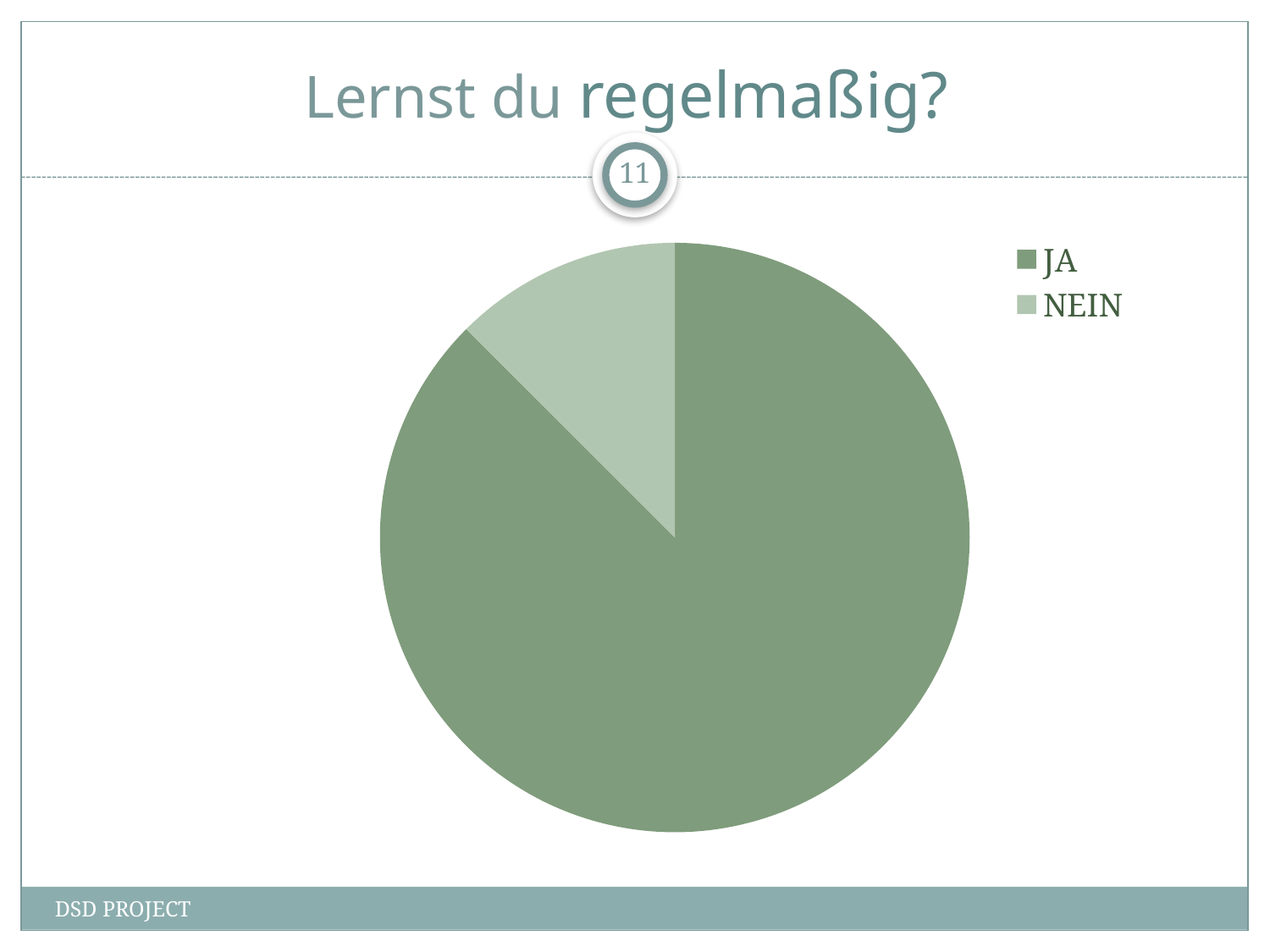
How many slices does the pie chart have? 2 How many entries does the legend of the pie chart list? 2 What kind of chart is shown on the slide? pie chart What is the title of the slide containing the pie chart? Lernst du regelmaßig? Which category has the largest slice in the pie chart? JA Which legend entry is shown in the lighter green colour? NEIN Which category has the smallest slice in the pie chart? NEIN Is the NEIN slice larger or smaller than the JA slice? smaller Which slice is larger in the pie chart, JA or NEIN? JA